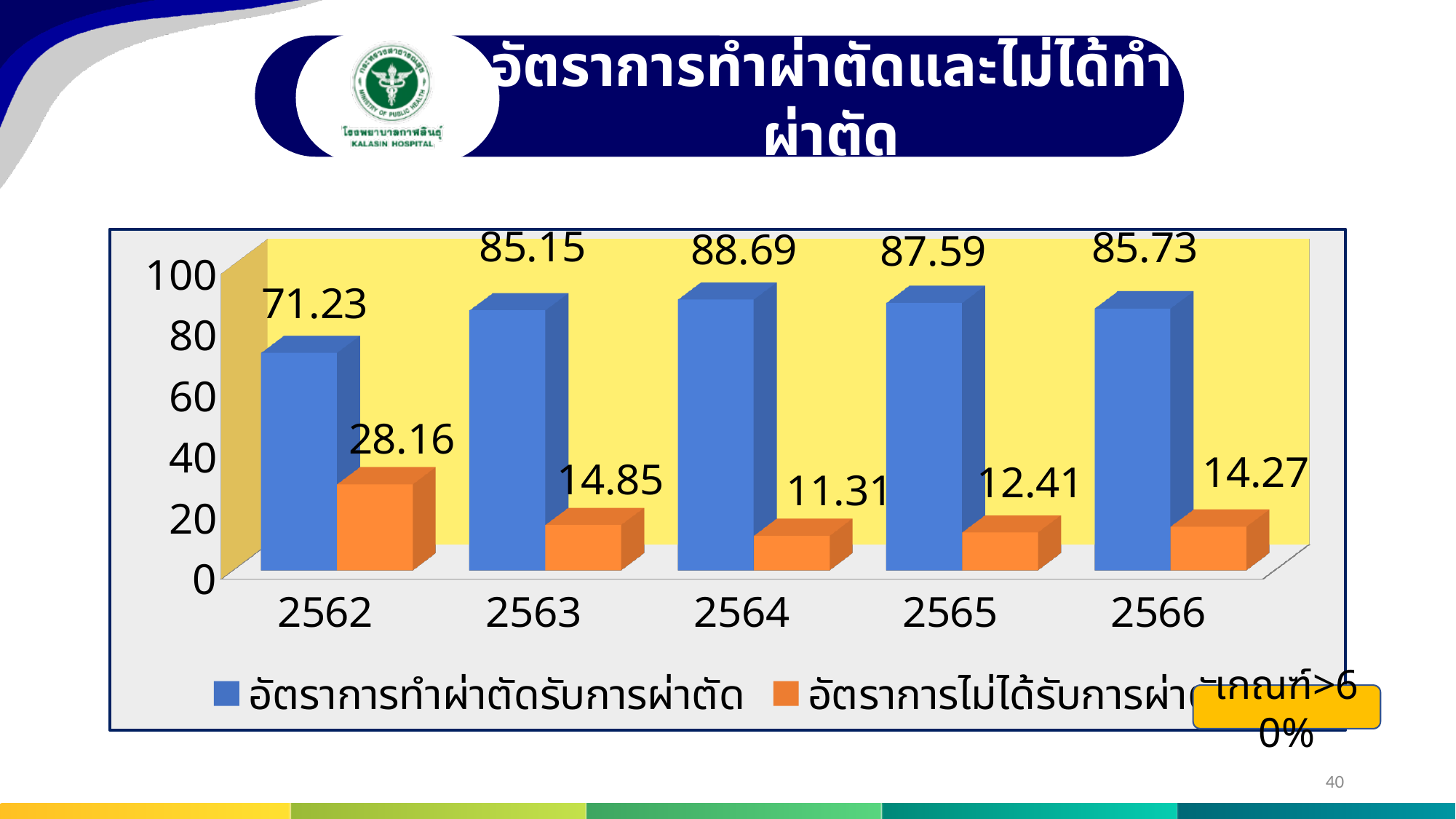
Is the value of อัตราการทำผ่าตัดรับการผ่าตัด for 2565 greater or less than 80? greater In which year is อัตราการทำผ่าตัดรับการผ่าตัด highest? 2564 How many series does the legend list? 2 What is the value of the orange series (อัตราการไม่ได้รับการผ่าตัด) for 2564? 11.31 Which is larger: the orange series value for 2562 or for 2566? 2562 What is the difference between the blue series values for 2563 and 2562? 13.92 What is the title of the chart on the slide? อัตราการทำผ่าตัดและไม่ได้ทำผ่าตัด How many years are shown on the x axis? 5 What is the value of อัตราการทำผ่าตัดรับการผ่าตัด for 2562? 71.23 In which year is the orange series (อัตราการไม่ได้รับการผ่าตัด) lowest? 2564 What is the value of อัตราการทำผ่าตัดรับการผ่าตัด for 2566? 85.73 What kind of chart is shown on the slide? Bar chart